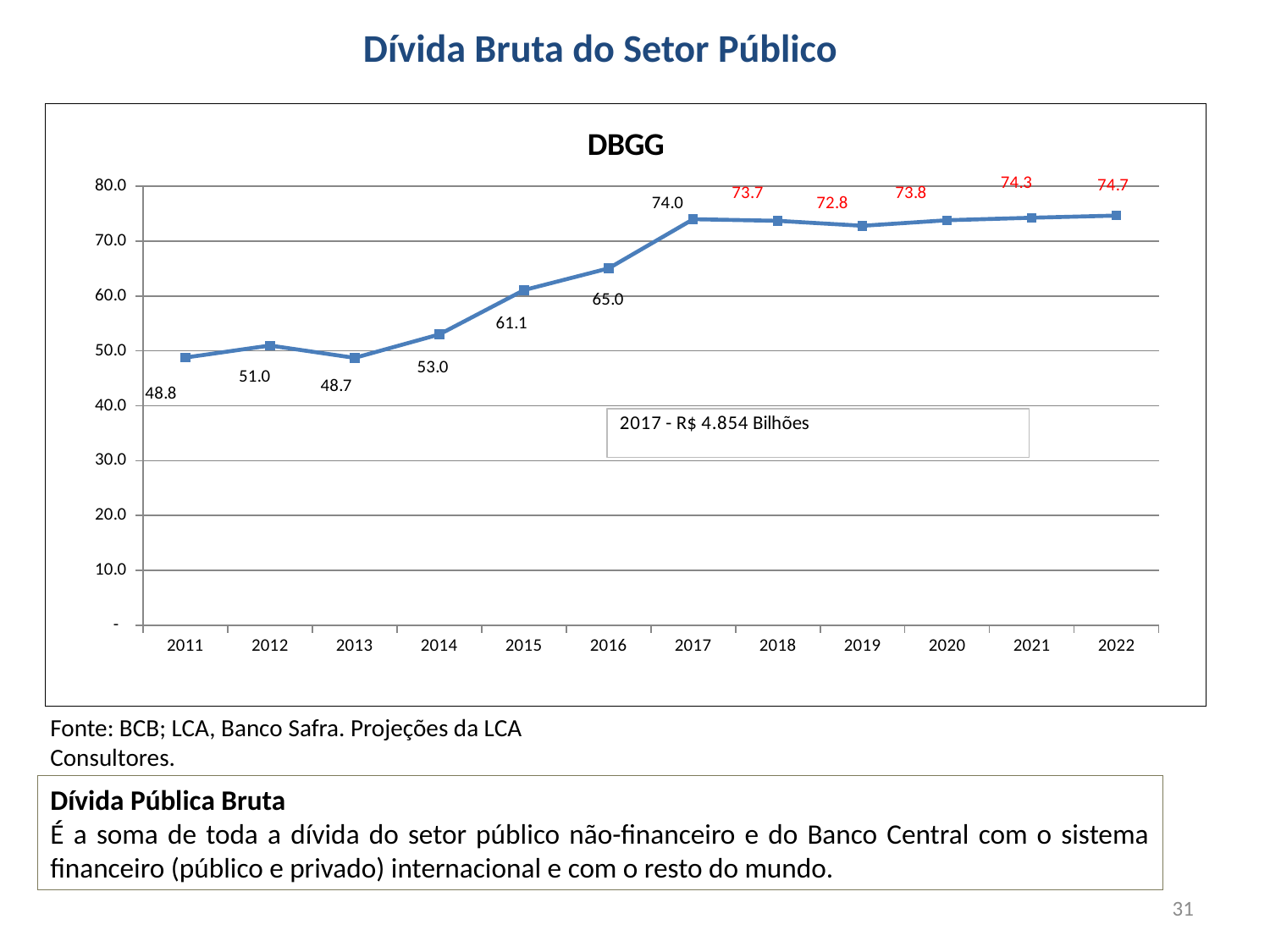
What is the DBGG value for 2022? 74.7 What is the difference between the DBGG values for 2017 and 2016? 9.0 What is the DBGG value for 2011? 48.8 Which year has the highest DBGG value? 2022 How many years are plotted on the DBGG chart? 12 What kind of chart is the DBGG chart? line chart What is the title of the chart? DBGG Which year has a larger DBGG value, 2014 or 2015? 2015 What is the DBGG value for 2019? 72.8 What is the DBGG value for 2017? 74.0 Does the DBGG value generally rise or fall from 2013 to 2017? rise Which year has the lowest DBGG value? 2013